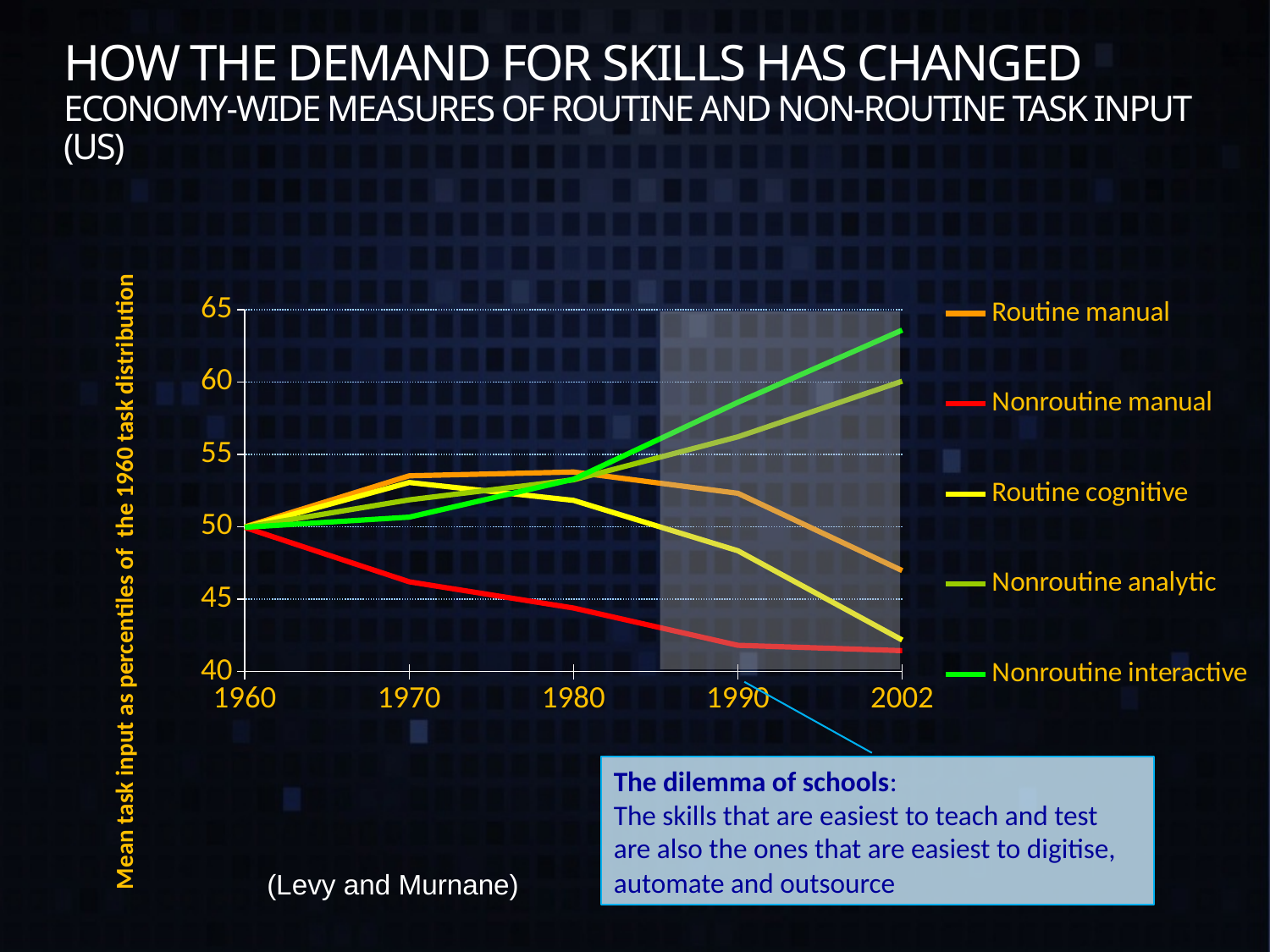
Is the value for Routine cognitive in 2002 greater or less than 45? less Which series has the lowest value in 2002? Nonroutine manual Which is larger in 2002, Routine manual or Routine cognitive? Routine manual Is the value for Nonroutine interactive in 2002 greater or less than 60? greater What kind of chart is shown on the slide? line chart What value do all series have in 1960? 50 How many years are marked on the x axis? 5 What is the label of the y axis? Mean task input as percentiles of the 1960 task distribution Does the Nonroutine manual series rise or fall from 1960 to 2002? fall Which series has the highest value in 2002? Nonroutine interactive Is the value for Nonroutine manual in 1990 greater or less than 45? less How many series does the legend list? 5